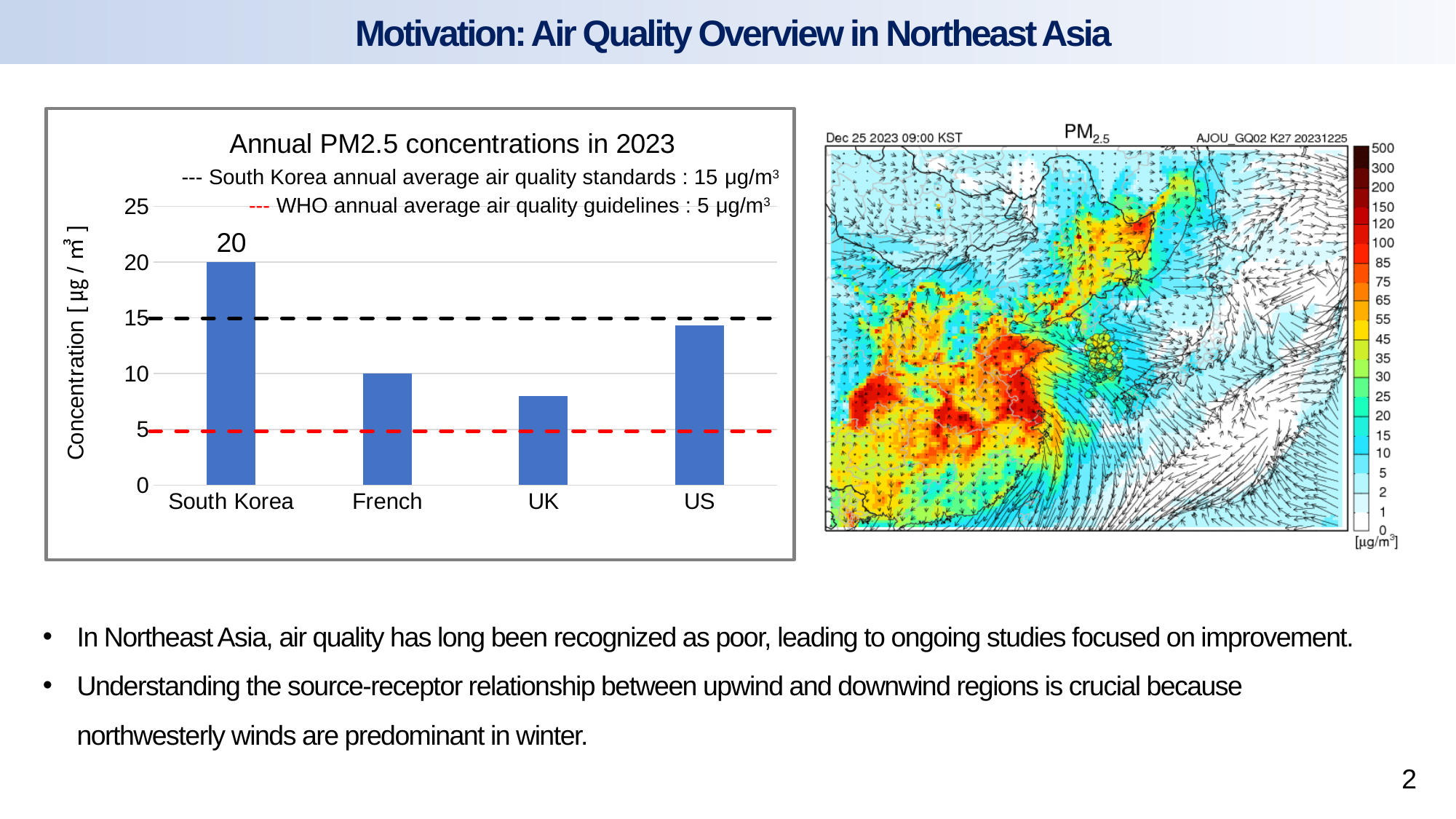
In the chart 'Annual PM2.5 concentrations in 2023', which country has the lowest PM2.5 concentration? UK In the chart 'Annual PM2.5 concentrations in 2023', which country has the highest PM2.5 concentration? South Korea In the chart 'Annual PM2.5 concentrations in 2023', how many countries are shown on the x axis? 4 In the chart 'Annual PM2.5 concentrations in 2023', what value does the red dashed line (WHO annual average air quality guidelines) represent? 5 µg/m³ In the chart 'Annual PM2.5 concentrations in 2023', is the value for US greater or less than 15? less What kind of chart is 'Annual PM2.5 concentrations in 2023'? bar chart What is the title of the bar chart on the left of the slide? Annual PM2.5 concentrations in 2023 In the chart 'Annual PM2.5 concentrations in 2023', which has a higher value, US or French? US In the chart 'Annual PM2.5 concentrations in 2023', is the value for UK greater or less than 10? less In the chart 'Annual PM2.5 concentrations in 2023', what is the value for South Korea? 20 In the chart 'Annual PM2.5 concentrations in 2023', what is the difference between the values for South Korea and French? 10 In the chart 'Annual PM2.5 concentrations in 2023', what is the value for French? 10